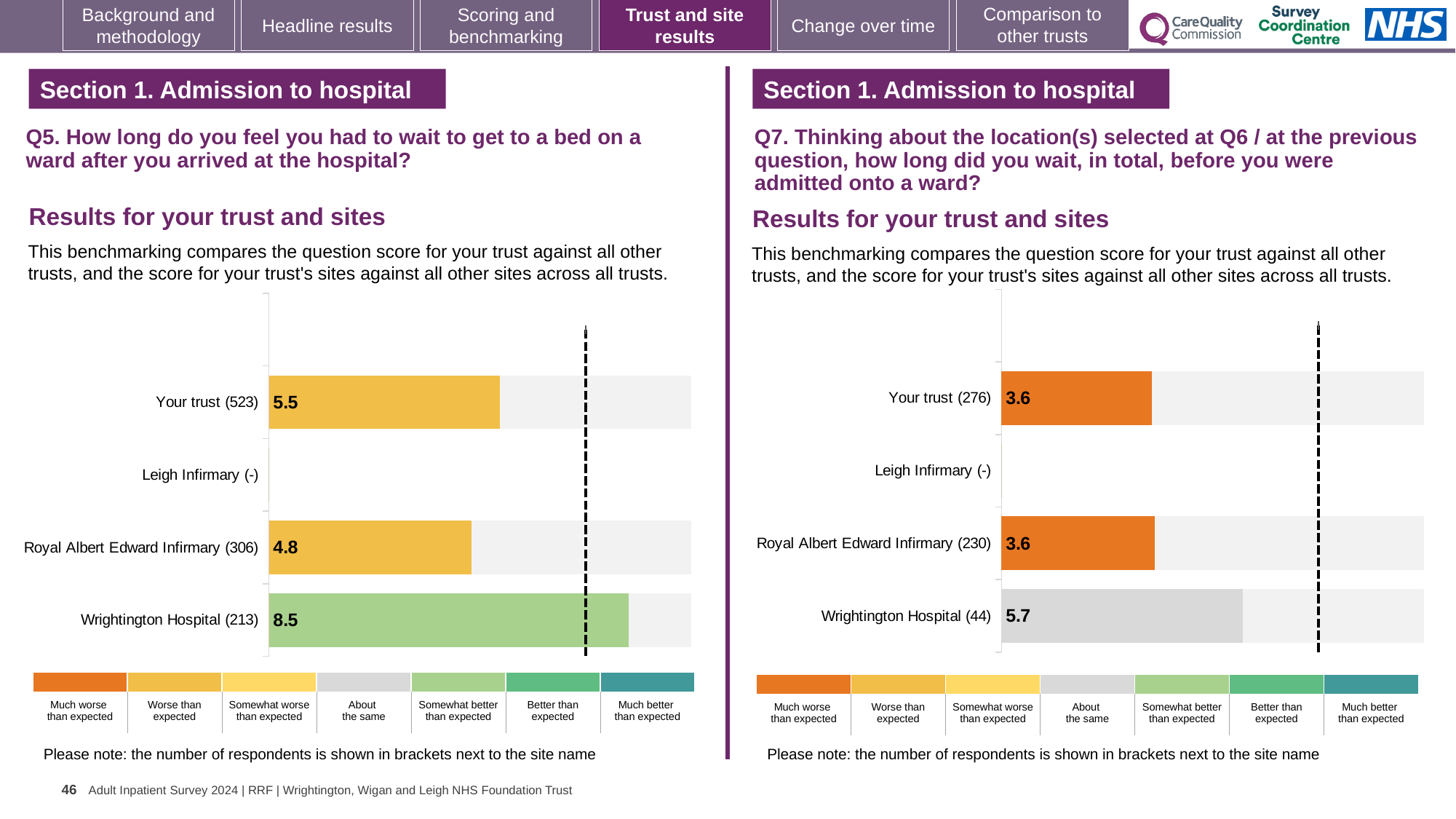
What kind of chart is used on the left for Q5? bar chart In the Q7 chart on the right, which site or trust has the highest score? Wrightington Hospital In the Q5 chart on the left, which site or trust has the highest score? Wrightington Hospital In the Q7 chart on the right, what is the difference between the scores for Wrightington Hospital and Your trust? 2.1 In the Q5 chart on the left, what is the score for Your trust? 5.5 In the Q7 chart on the right, what is the score for Royal Albert Edward Infirmary? 3.6 In the Q7 chart on the right, how many respondents are shown in brackets for Your trust? 276 In the Q5 chart on the left, what is the difference between the scores for Wrightington Hospital and Royal Albert Edward Infirmary? 3.7 In the Q5 chart on the left, what is the score for Wrightington Hospital? 8.5 In the Q5 chart on the left, is the score for Your trust larger or smaller than the score for Royal Albert Edward Infirmary? larger In the Q7 chart on the right, what is the score for Wrightington Hospital? 5.7 In the Q5 chart on the left, which site or trust with a plotted score has the lowest score? Royal Albert Edward Infirmary